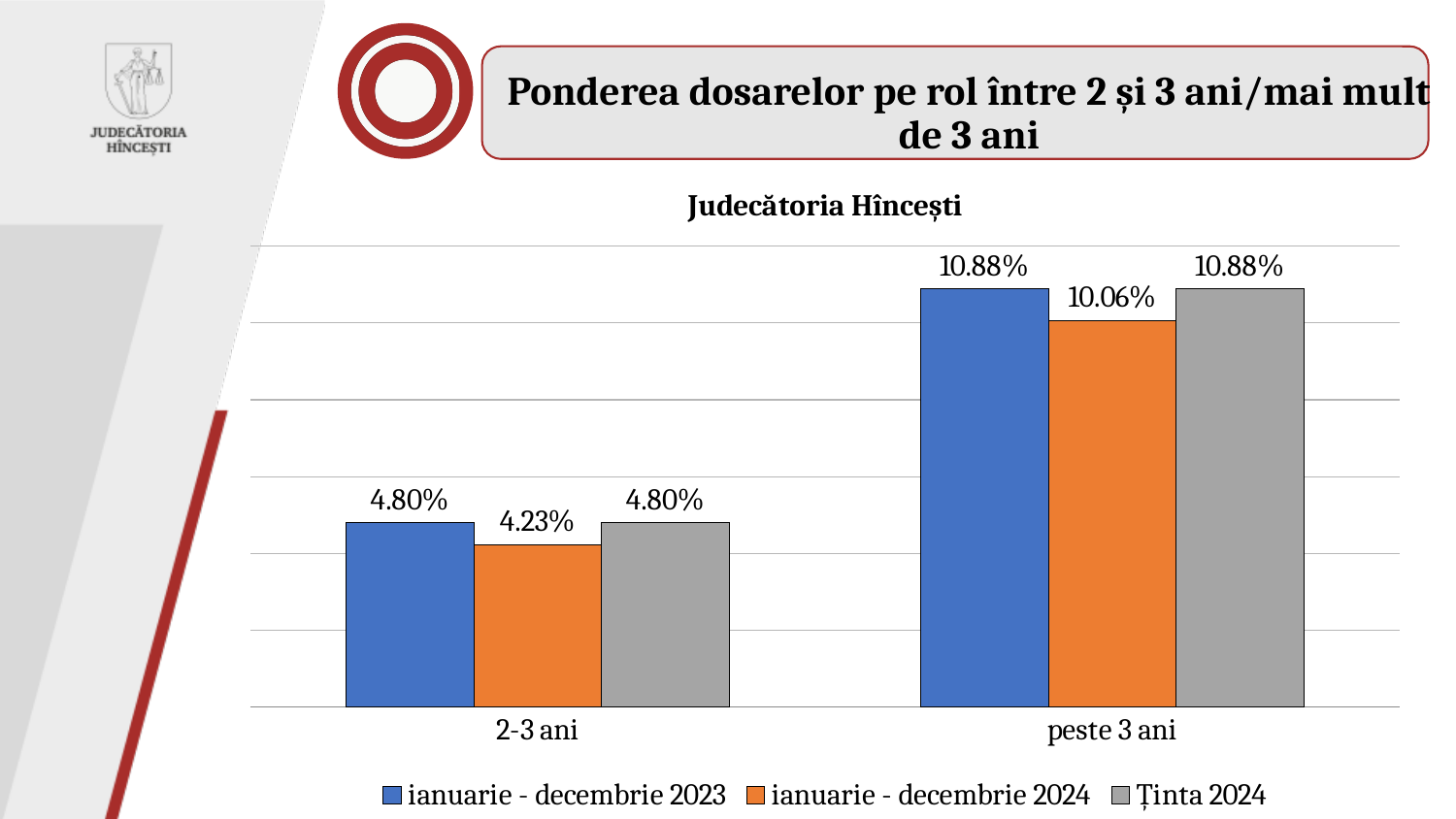
What kind of chart is shown on the slide? bar chart How many categories are shown on the x axis? 2 What is the value for 'ianuarie - decembrie 2023' in the 'peste 3 ani' category? 10.88% Which is larger: the 'ianuarie - decembrie 2024' value for '2-3 ani' or for 'peste 3 ani'? peste 3 ani How many series does the legend list? 3 Which series has the lowest value in the 'peste 3 ani' category? ianuarie - decembrie 2024 Which category has the highest value for 'ianuarie - decembrie 2024'? peste 3 ani What is the value for 'ianuarie - decembrie 2024' in the 'peste 3 ani' category? 10.06% What is the value for 'Ținta 2024' in the '2-3 ani' category? 4.80% What is the difference between the 'ianuarie - decembrie 2023' and 'ianuarie - decembrie 2024' values in the 'peste 3 ani' category? 0.82% What is the value for 'ianuarie - decembrie 2024' in the '2-3 ani' category? 4.23% What is the difference between the 'Ținta 2024' and 'ianuarie - decembrie 2024' values in the '2-3 ani' category? 0.57%